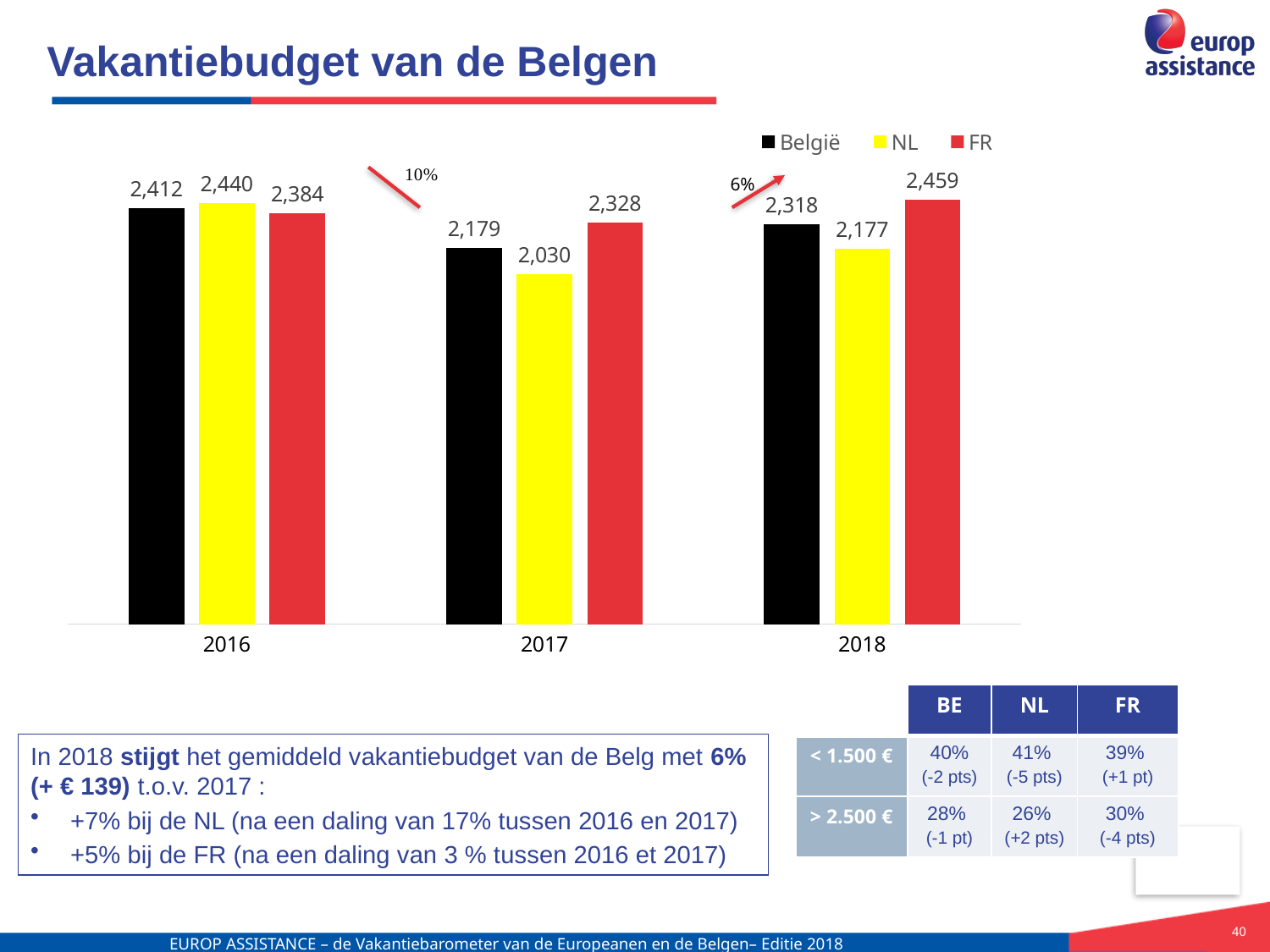
What is the value for België in 2016? 2,412 Which series has the highest value in 2018? FR How many series does the legend list? 3 What is the difference between the FR and NL values in 2017? 298 Which series has the lowest value in 2017? NL What is the difference between the België values for 2018 and 2017? 139 What is the value for FR in 2018? 2,459 Which is larger, the NL value in 2016 or the NL value in 2018? NL in 2016 How many years are shown on the x axis? 3 Which colour represents NL in the chart? Yellow What is the value for NL in 2017? 2,030 What kind of chart is shown on the slide? Bar chart